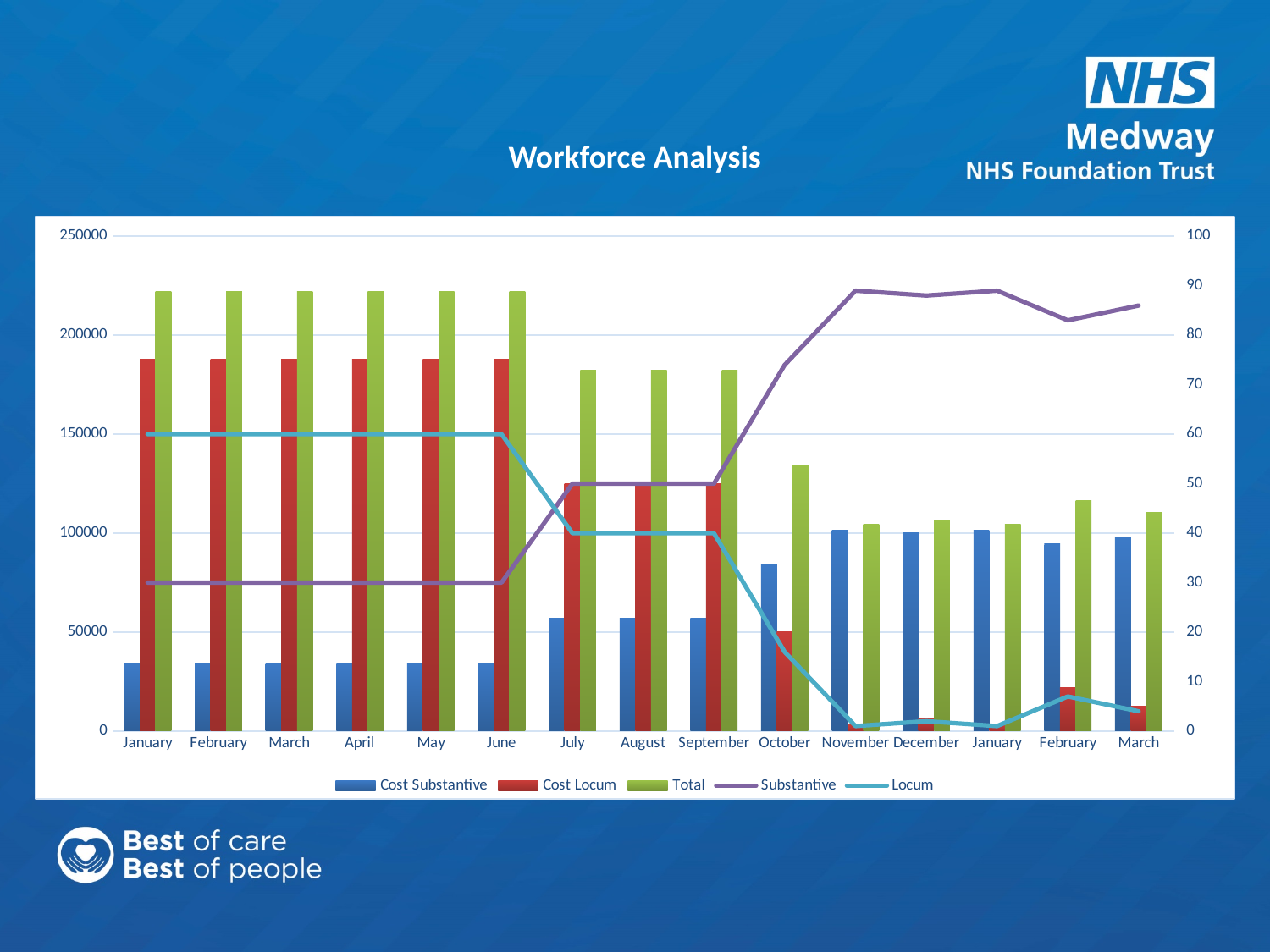
Is the Cost Substantive bar for the first January greater or less than 50000? less Is the Cost Locum bar for November greater or less than 50000? less Which is larger, the Total bar for the first January or the Total bar for the final March? The first January How many series does the legend list? 5 Does the Substantive line rise or fall between June and November? Rises Is the Total bar for the first January greater or less than 200000? greater Which is larger, the Cost Locum bar for the first January or the Cost Locum bar for July? The first January How many months are shown along the x axis? 15 What is the title of the chart? Workforce Analysis Which colour represents the Total series in the legend? Green What kind of chart is shown on the slide? A combined bar and line chart